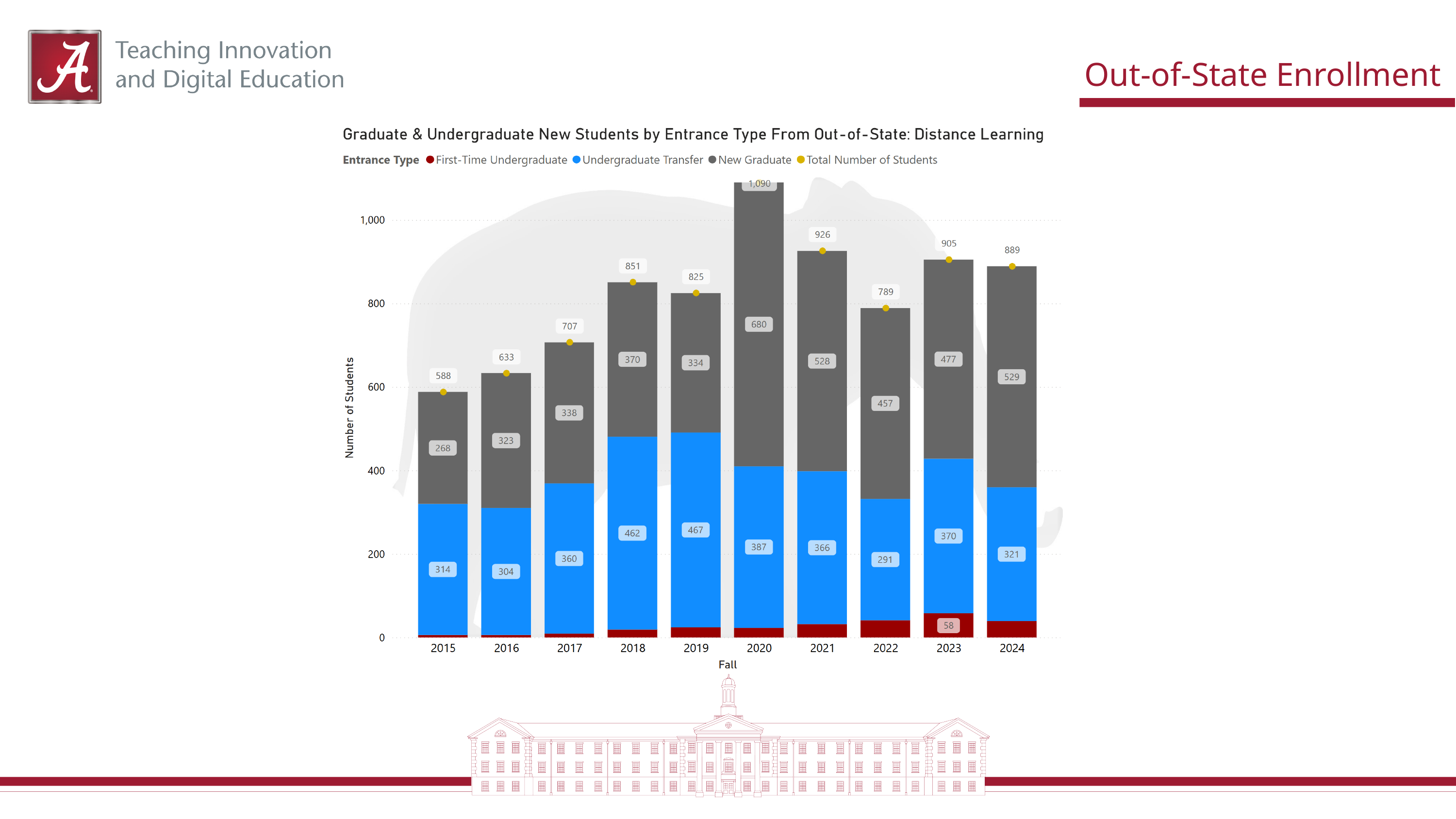
How many entries does the Entrance Type legend list? 4 How many years are shown on the x axis? 10 Which year has the highest Total Number of Students? 2020 Which year has the larger New Graduate value, 2020 or 2021? 2020 What is the Undergraduate Transfer value for Fall 2019? 467 What is the Total Number of Students for Fall 2020? 1,090 Which year has the lowest Total Number of Students? 2015 What is the difference between the Total Number of Students in 2021 and in 2022? 137 What kind of chart is shown on the slide? Stacked bar chart How many New Graduate students are shown for Fall 2024? 529 What is the First-Time Undergraduate value for Fall 2023? 58 Does the Total Number of Students rise or fall from 2015 to 2018? Rise